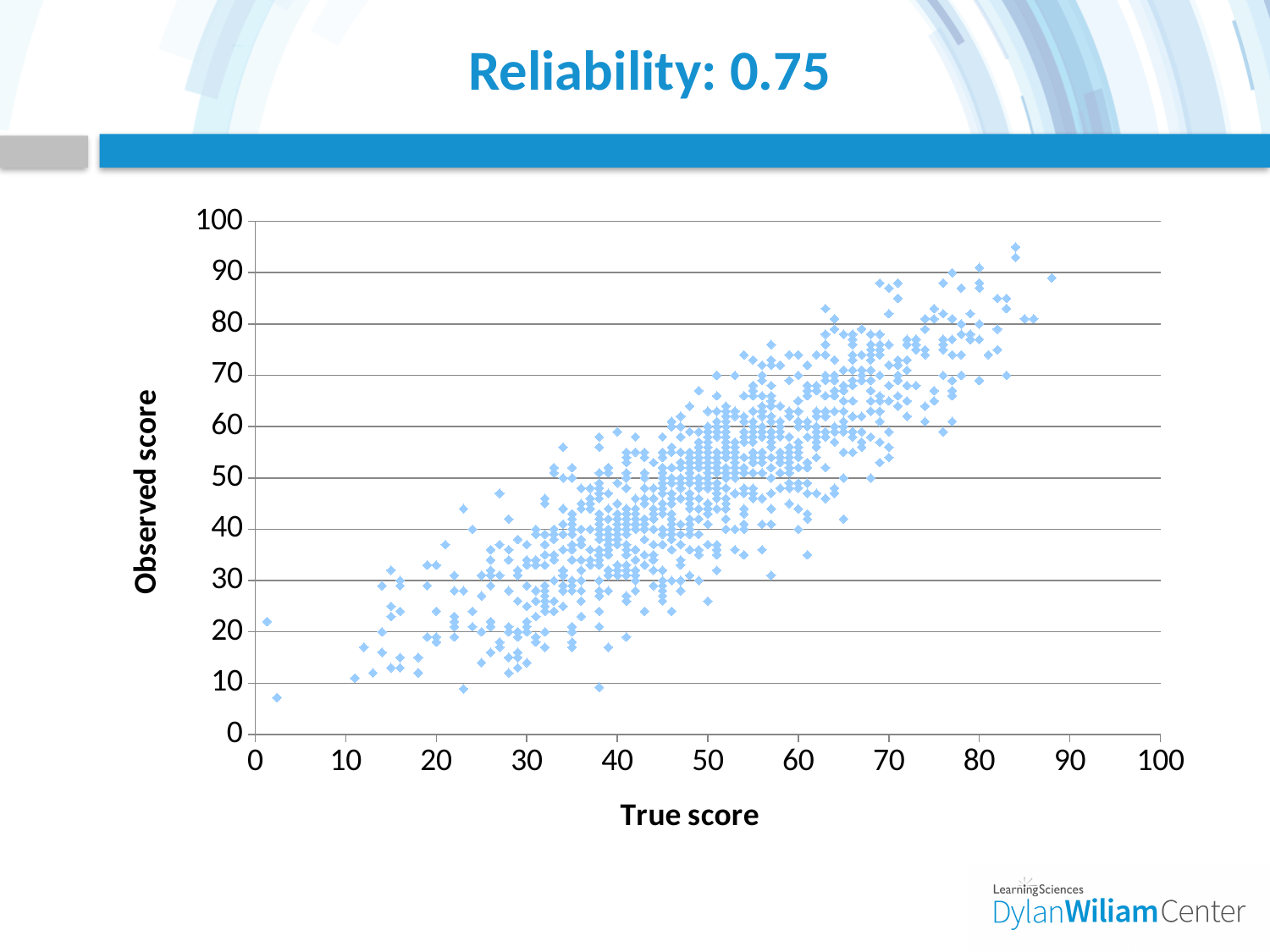
Is the largest true score plotted on the chart greater or less than 90? less Is the lowest observed score plotted on the chart greater or less than 10? less What is the title of the chart? Reliability: 0.75 Is the highest observed score plotted on the chart greater or less than 90? greater What kind of chart is shown on the slide? scatter plot As the true score increases along the x axis, does the observed score generally rise or fall? rise What is the label on the horizontal axis of the chart? True score